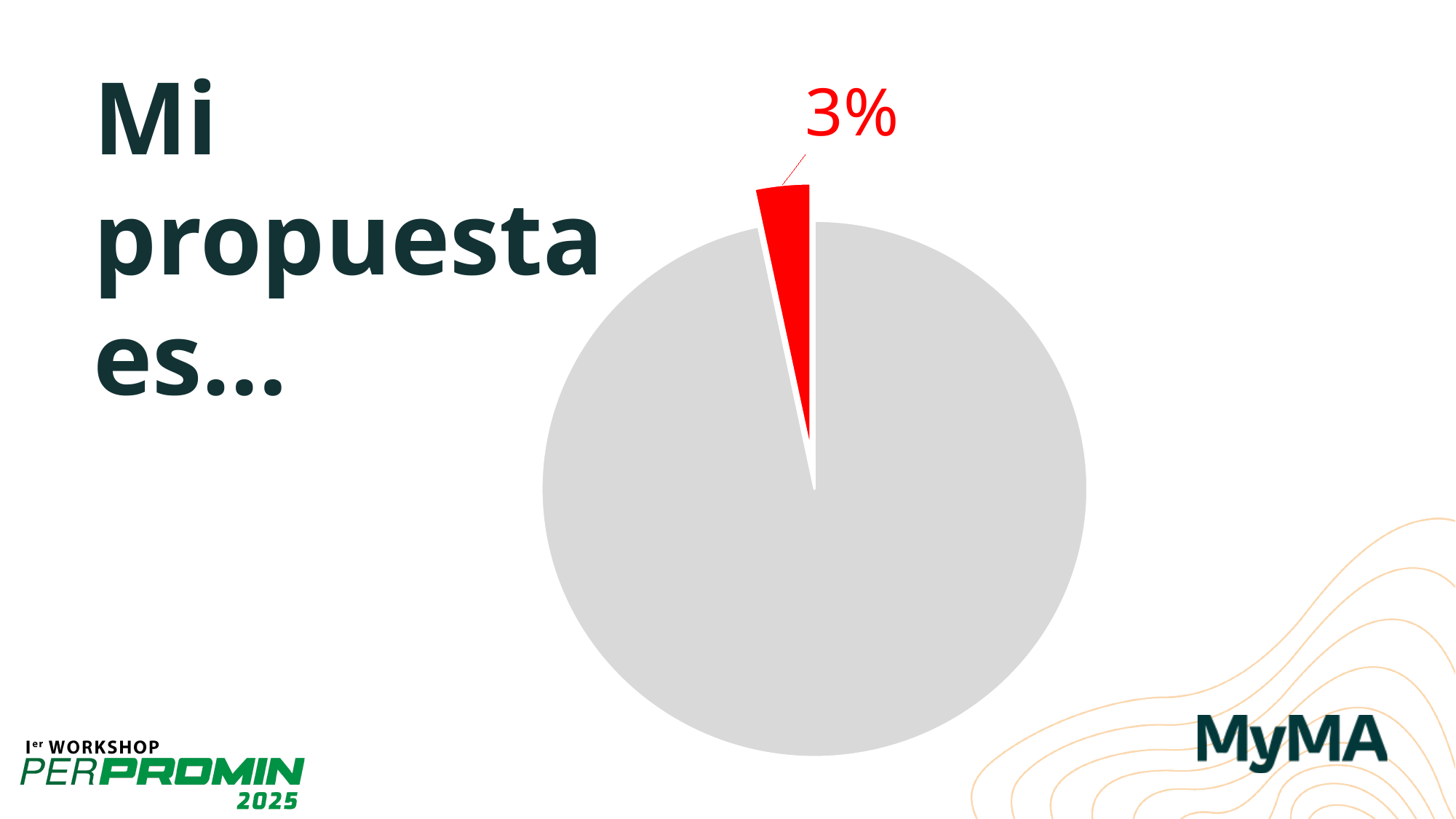
Which slice of the pie chart is the smallest? the red slice Which slice of the pie chart is the largest? the grey slice How many slices of the pie chart have a data label printed? 1 What kind of chart is shown on the slide? pie chart Which slice of the pie chart is larger, the red one or the grey one? the grey one What value is printed on the red slice of the pie chart? 3% How many slices does the pie chart have? 2 What colour is the slice of the pie chart that carries the 3% label? red